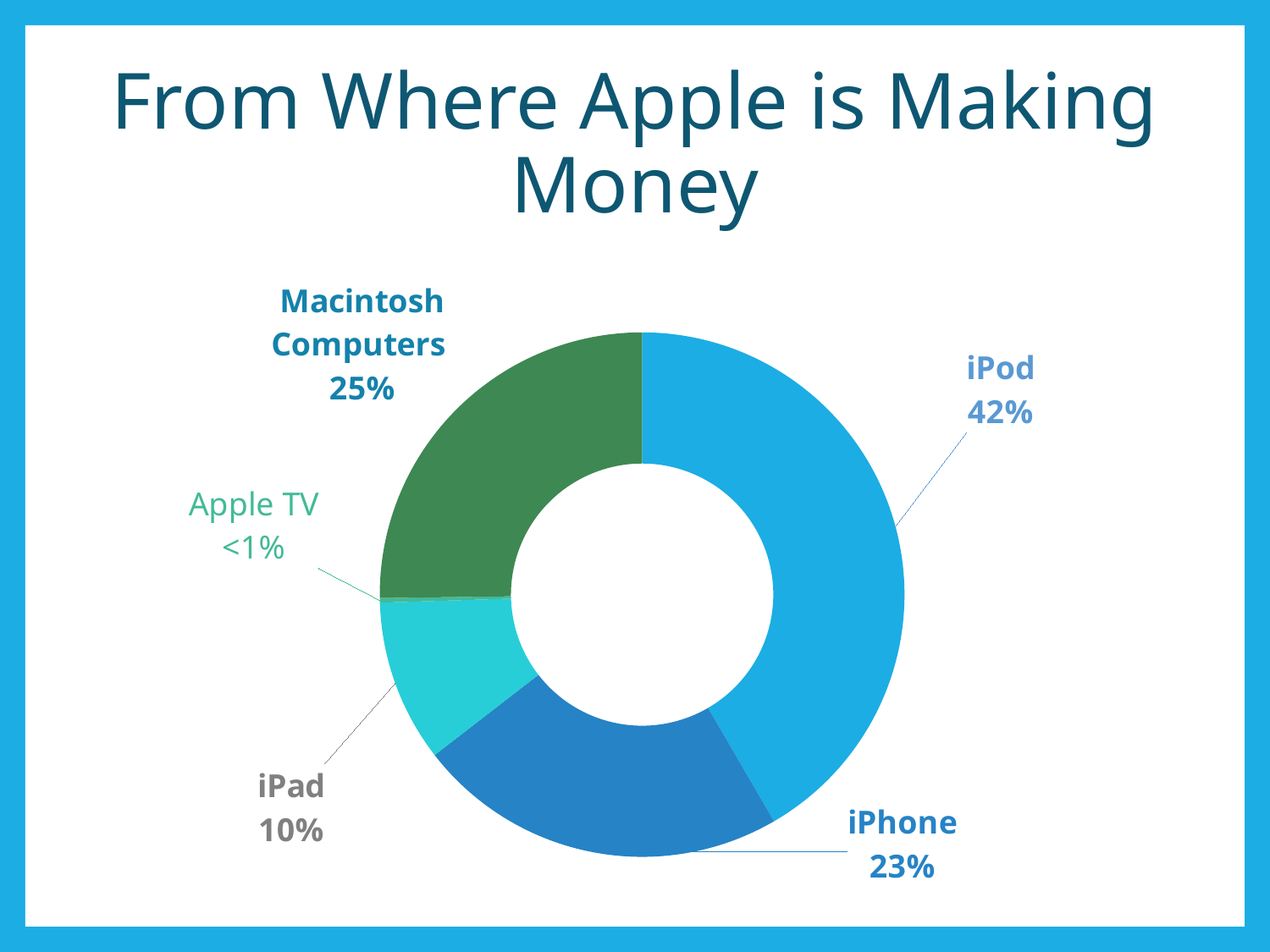
What share of Apple's revenue comes from the iPhone? 23% What share is shown for Apple TV? <1% What is the title of the slide? From Where Apple is Making Money Which has a larger share, Macintosh Computers or iPhone? Macintosh Computers Which product has the largest share of the chart? iPod How many product categories are shown in the chart? 5 What is the difference in percentage points between the iPod share and the iPad share? 32 What share of Apple's revenue comes from the iPod? 42% What kind of chart is shown on the slide? Doughnut (pie) chart What share of Apple's revenue comes from Macintosh Computers? 25% Which product has the smallest share of the chart? Apple TV What share of Apple's revenue comes from the iPad? 10%